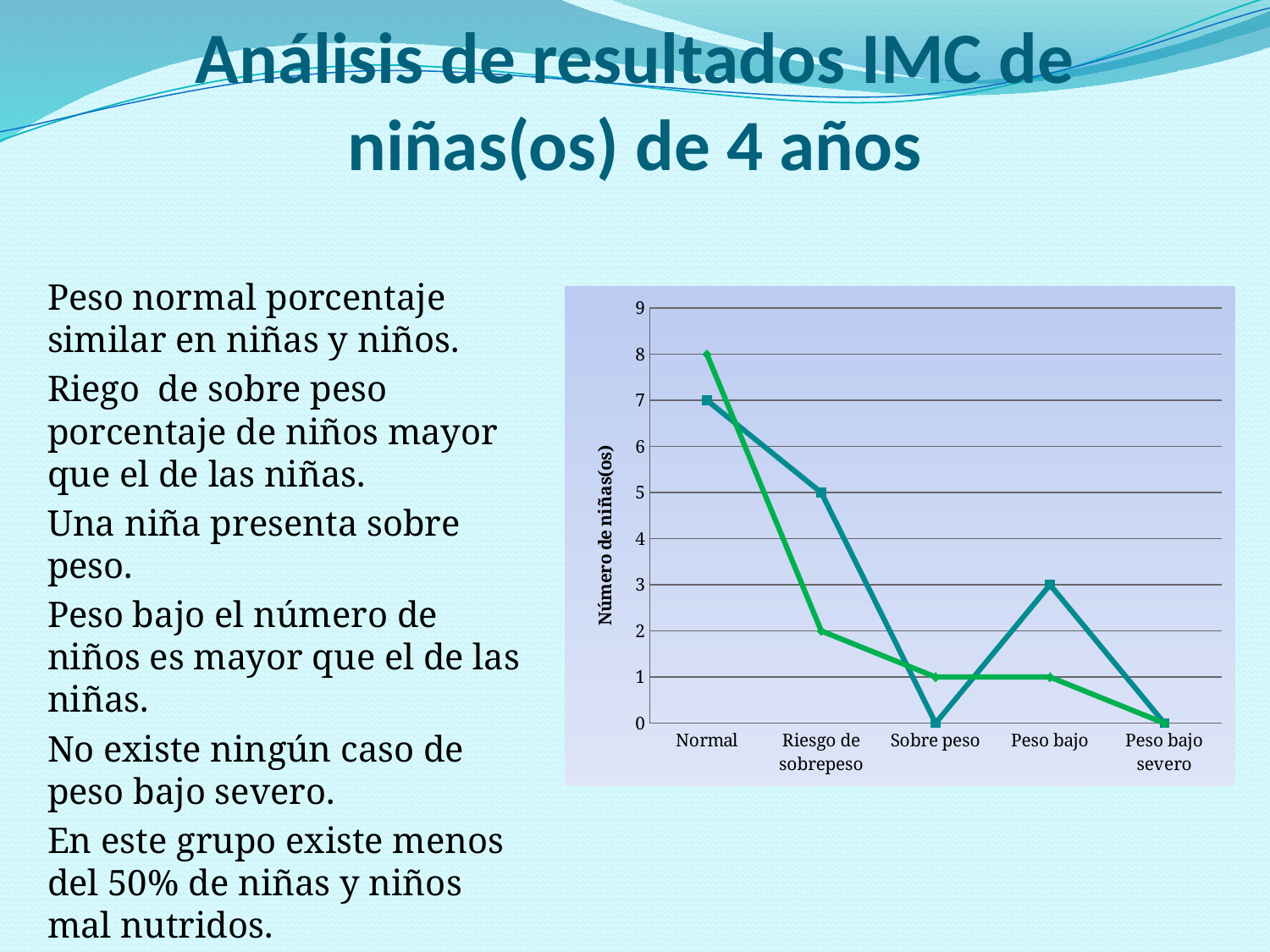
What is the value of the green line for the Normal category? 8 Which line has the larger value for Sobre peso, the green line or the teal line? green line What is the value of both lines for Peso bajo severo? 0 What is the value of the green line for Riesgo de sobrepeso? 2 For which category does the green line reach its highest value? Normal How many categories are shown on the x axis of the chart? 5 What is the difference between the teal line and the green line for Riesgo de sobrepeso? 3 What is the value of the teal line for Peso bajo? 3 What is the value of the teal line for Riesgo de sobrepeso? 5 What kind of chart is shown on the slide? line chart What is the label of the vertical axis of the chart? Número de niñas(os) What is the value of the teal line for the Normal category? 7